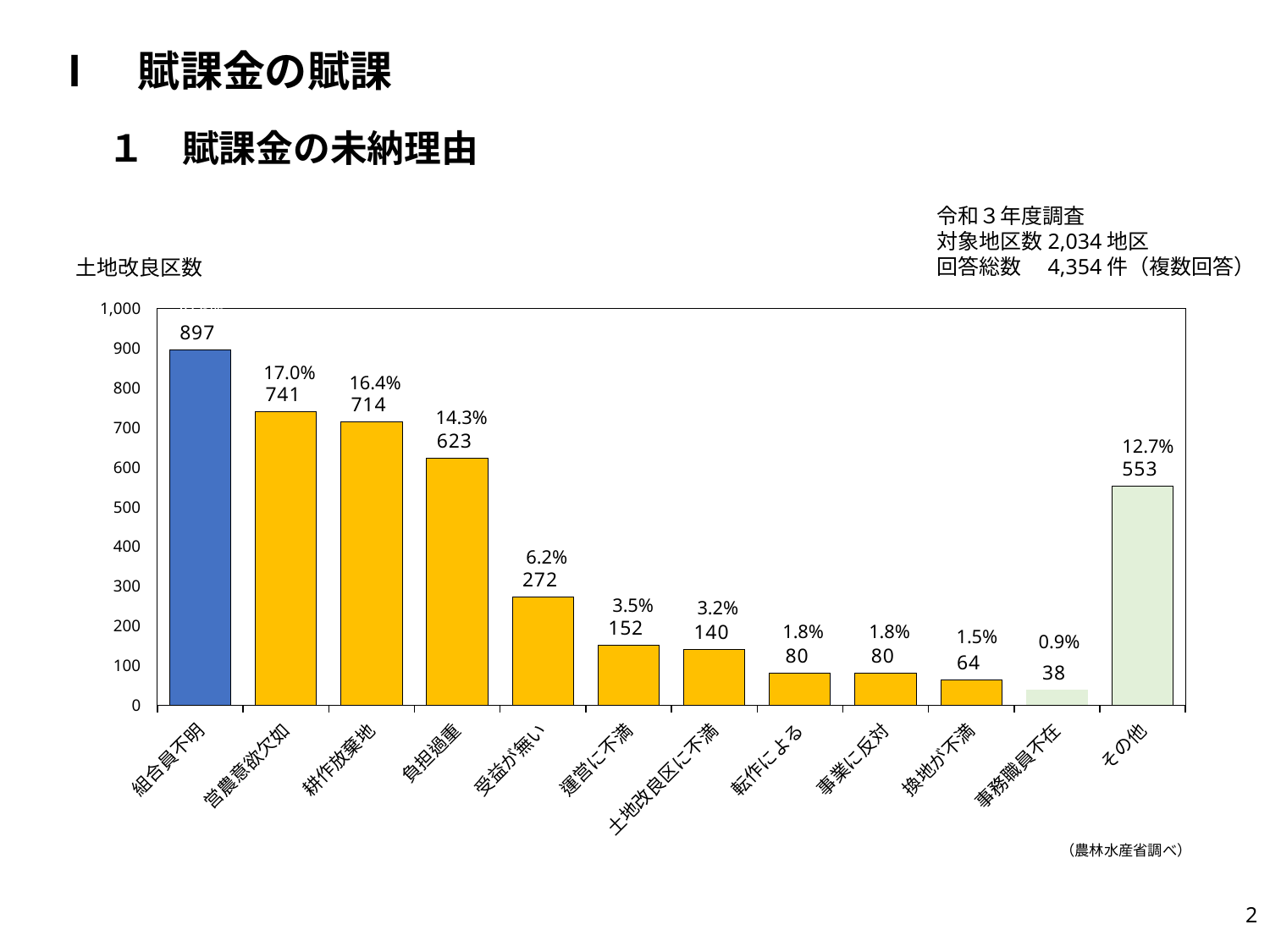
Is the value for 土地改良区に不満 greater or less than 200? less How many categories are shown on the x axis? 12 Which is larger, the value for 受益が無い or the value for 運営に不満? 受益が無い Which category has the lowest value? 事務職員不在 What kind of chart is shown on the slide? bar chart What percentage is shown for 耕作放棄地? 16.4% What is the difference between the values for 営農意欲欠如 and 耕作放棄地? 27 What is the value for その他? 553 Which category has the highest value? 組合員不明 What is the label shown above the y axis of the chart? 土地改良区数 What is the value for 組合員不明? 897 What is the value for 負担過重? 623